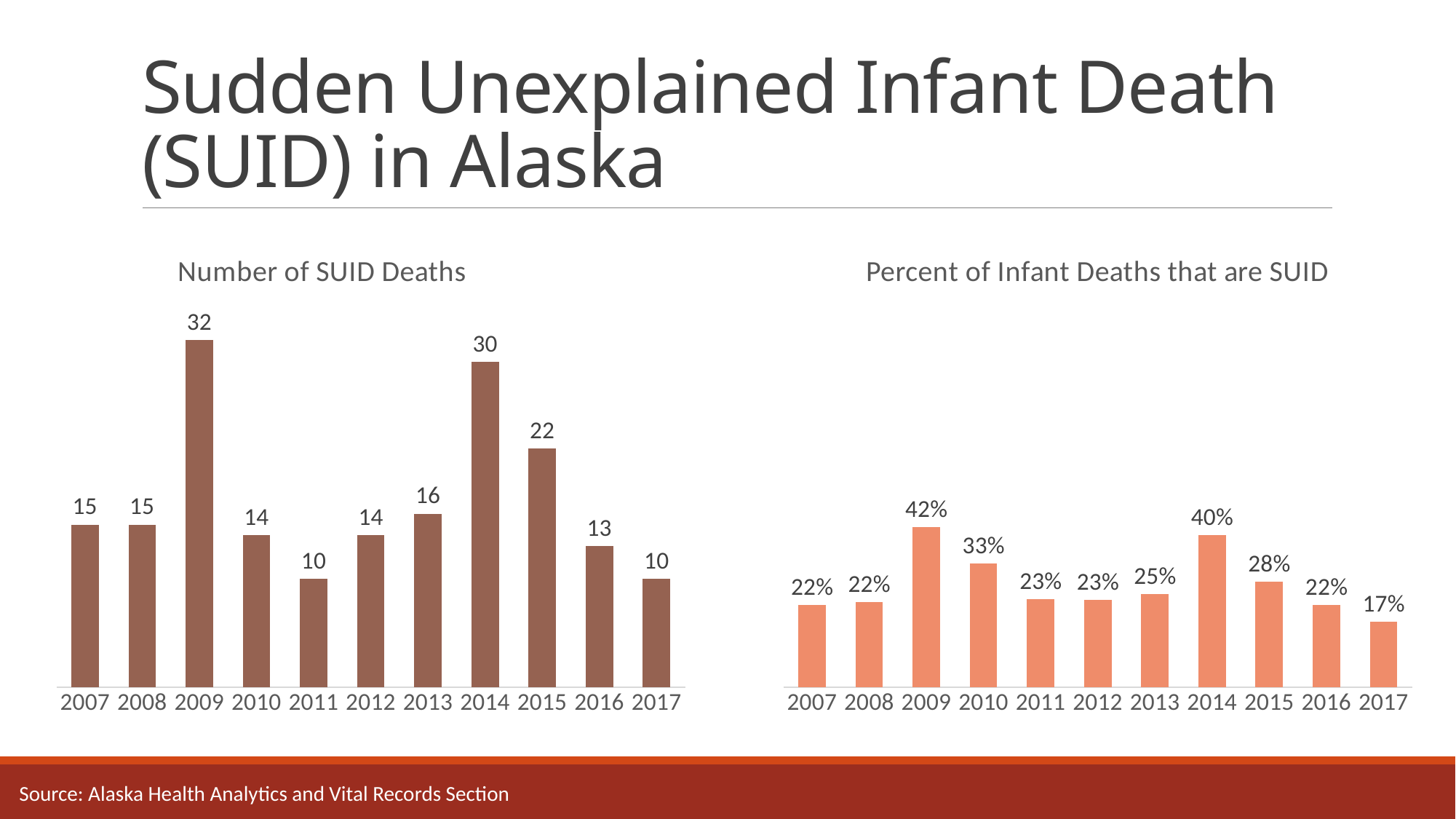
In the 'Number of SUID Deaths' chart, which is larger, the value for 2013 or the value for 2016? 2013 In the 'Percent of Infant Deaths that are SUID' chart, what is the difference between the values for 2009 and 2010? 9% In the 'Number of SUID Deaths' chart, what is the value for 2015? 22 How many years are shown in the 'Number of SUID Deaths' chart? 11 In the 'Number of SUID Deaths' chart, what is the difference between the values for 2009 and 2014? 2 What kind of chart is the 'Percent of Infant Deaths that are SUID' chart? Bar chart In the 'Percent of Infant Deaths that are SUID' chart, what is the value for 2017? 17% In the 'Percent of Infant Deaths that are SUID' chart, what is the value for 2014? 40% In the 'Number of SUID Deaths' chart, which year has the highest value? 2009 In the 'Number of SUID Deaths' chart, what is the value for 2009? 32 In the 'Percent of Infant Deaths that are SUID' chart, which year has the lowest value? 2017 In the 'Number of SUID Deaths' chart, do the values rise or fall from 2014 to 2017? Fall